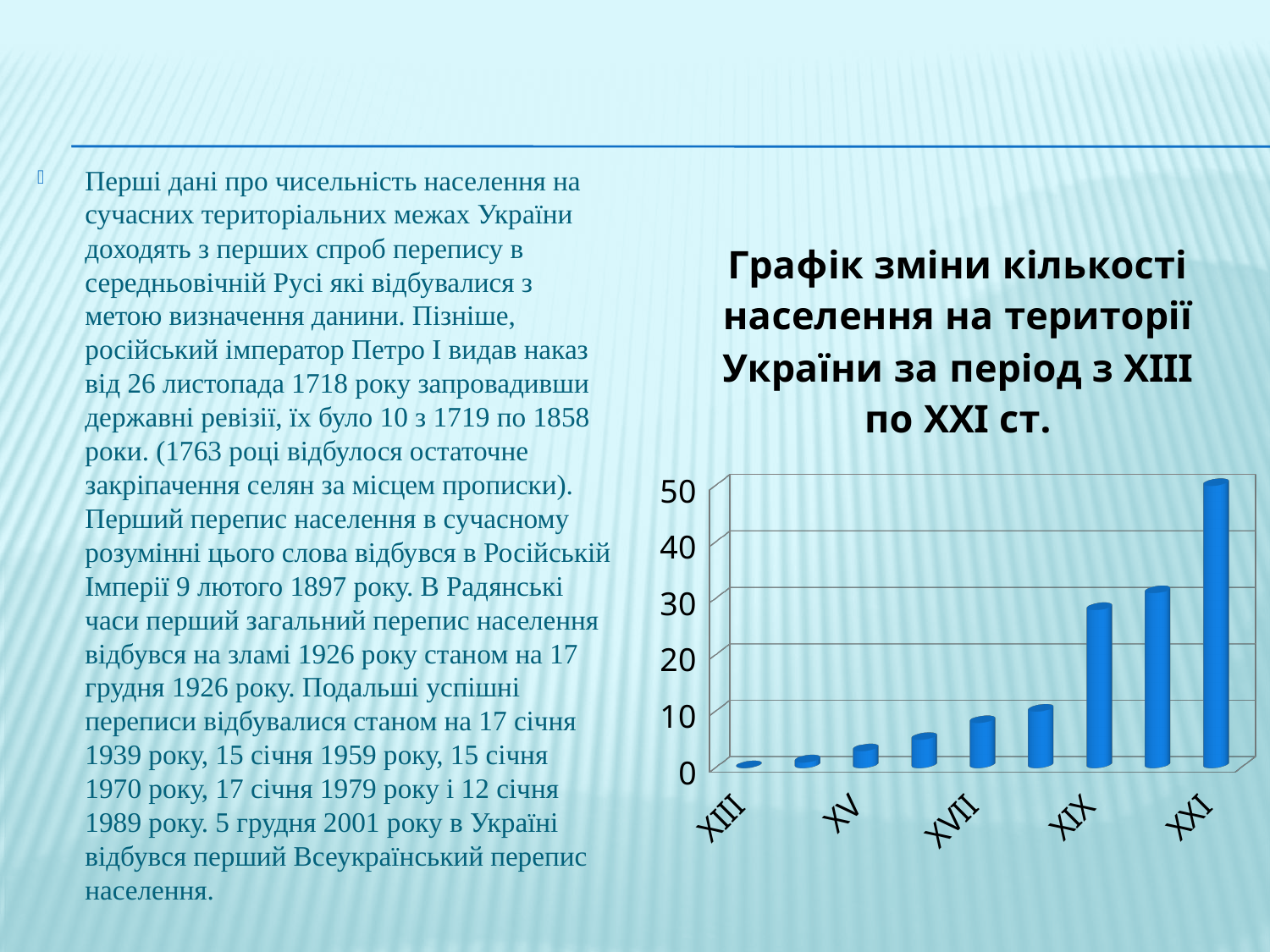
Is the value for XV greater or less than 10? less Which century has the highest value in the chart? XXI How many bars are plotted in the chart? 9 Is the value for XXI greater or less than 40? greater Which century has the lowest value in the chart? XIII What is the highest tick value shown on the vertical axis? 50 Is the value for XIX greater or less than 20? greater Which is larger, the value for XIII or the value for XV? XV Do the values rise or fall from XIII to XXI along the x axis? rise Which is larger, the value for XXI or the value for XIX? XXI What kind of chart is shown on the slide? bar chart